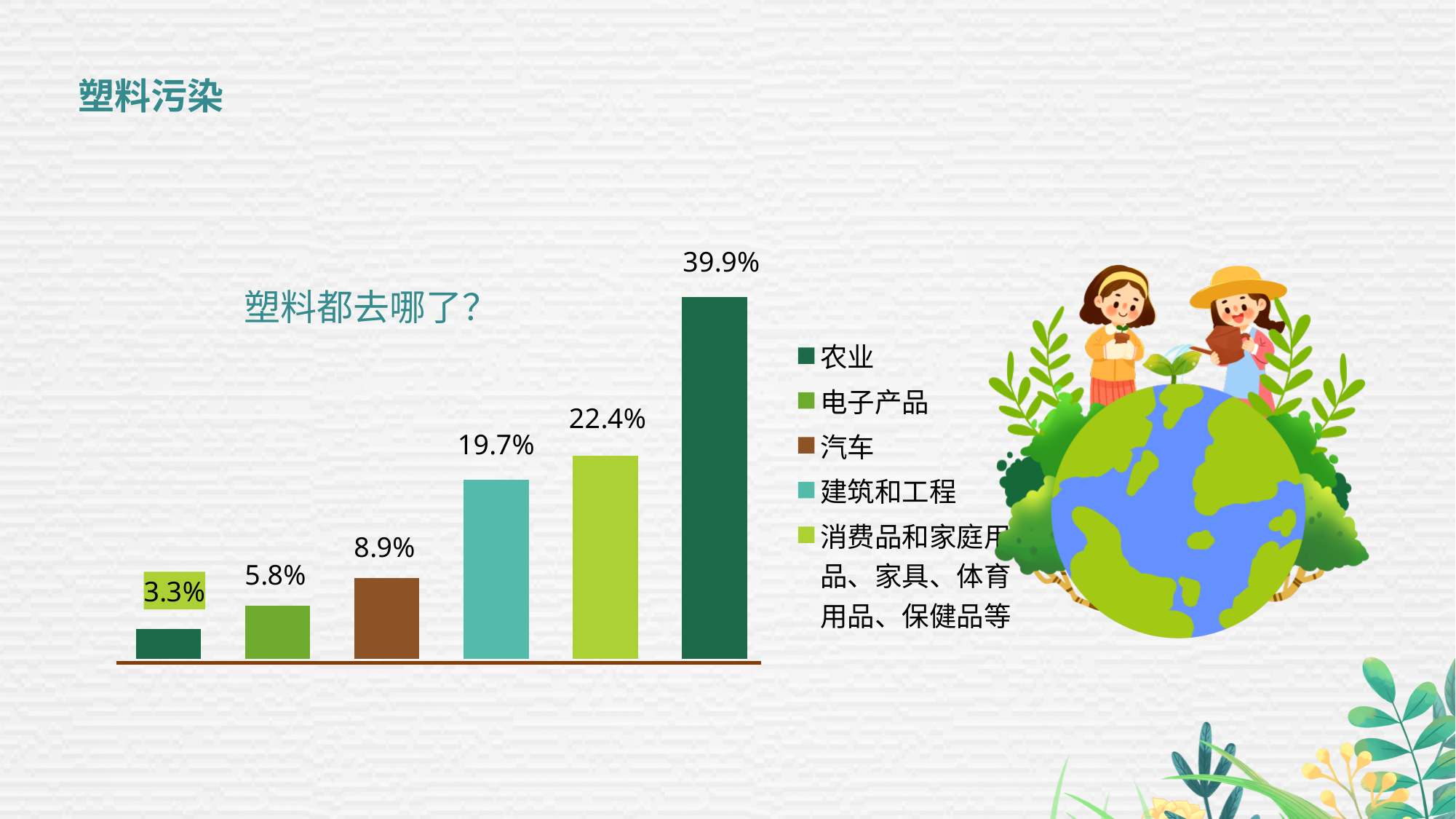
What is the value shown on the shortest bar in the chart? 3.3% What is the value of the brown bar (汽车) in the chart? 8.9% What is the title printed above the bar chart? 塑料都去哪了? What is the difference between the tallest bar (39.9%) and the second tallest bar (22.4%)? 17.5% What is the value shown on the tallest bar in the chart? 39.9% What is the value of the light green bar (消费品和家庭用品、家具、体育用品、保健品等) in the chart? 22.4% How many bars are plotted in the chart? 6 Which is larger, the value for 汽车 (8.9%) or the value for 电子产品 (5.8%)? 汽车 What is the value of the teal bar (建筑和工程) in the chart? 19.7% What type of chart is shown under the title "塑料都去哪了?"? bar chart Do the bar values rise or fall from left to right across the chart? rise What is the value of the bar for 电子产品 in the chart? 5.8%